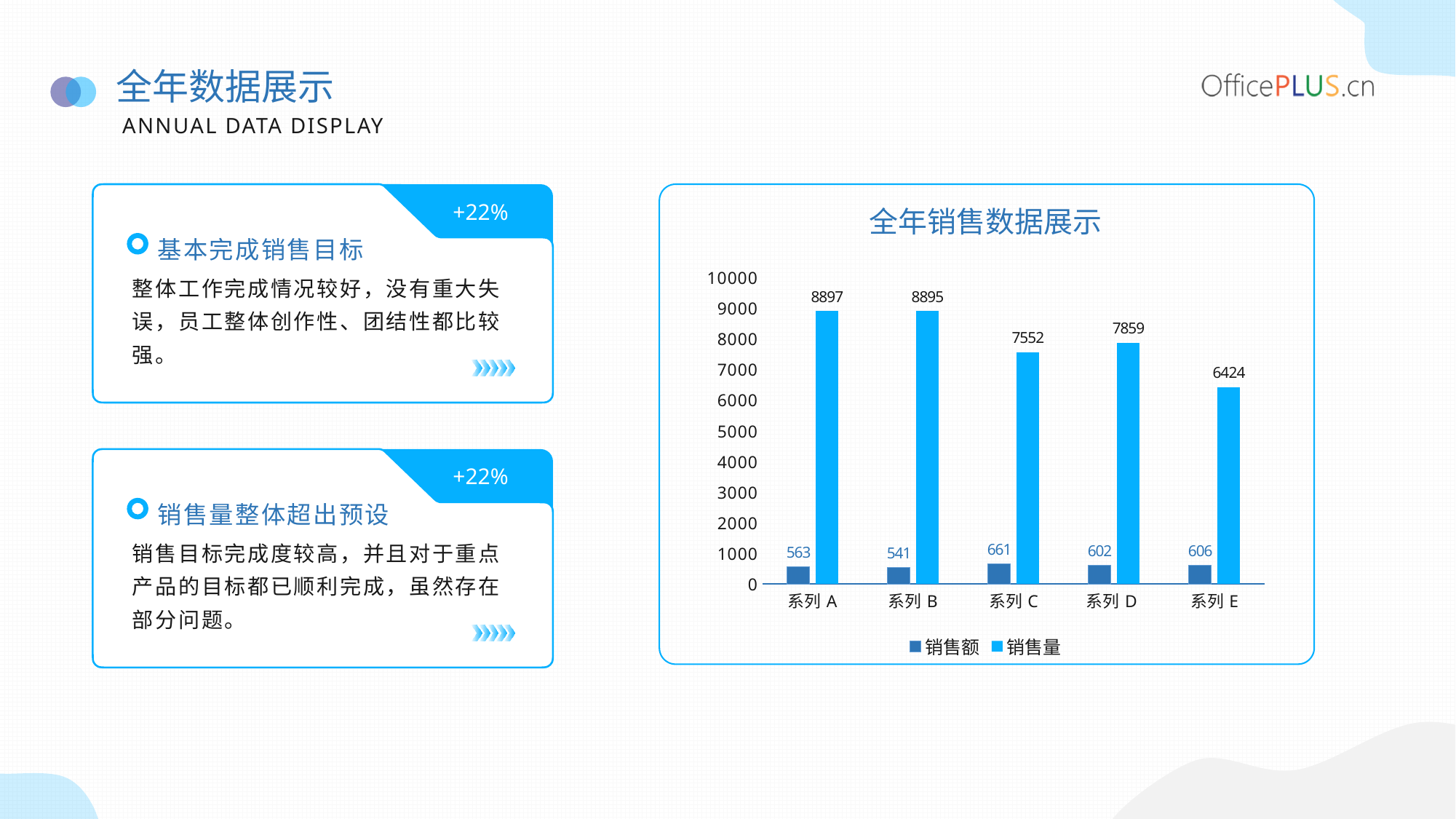
Is the 销售量 value for 系列 E greater or less than 7000? less How many series does the legend list? 2 Which category has the highest 销售额? 系列 C How many categories are shown on the x axis? 5 What kind of chart is shown on the slide? bar chart What is the 销售量 value for 系列 A? 8897 What is the title of the chart? 全年销售数据展示 What is the 销售额 value for 系列 C? 661 Which category has the lowest 销售额? 系列 B Which is larger, the 销售量 of 系列 C or 系列 D? 系列 D Which category has the lowest 销售量? 系列 E What is the difference between the 销售量 of 系列 A and 系列 E? 2473